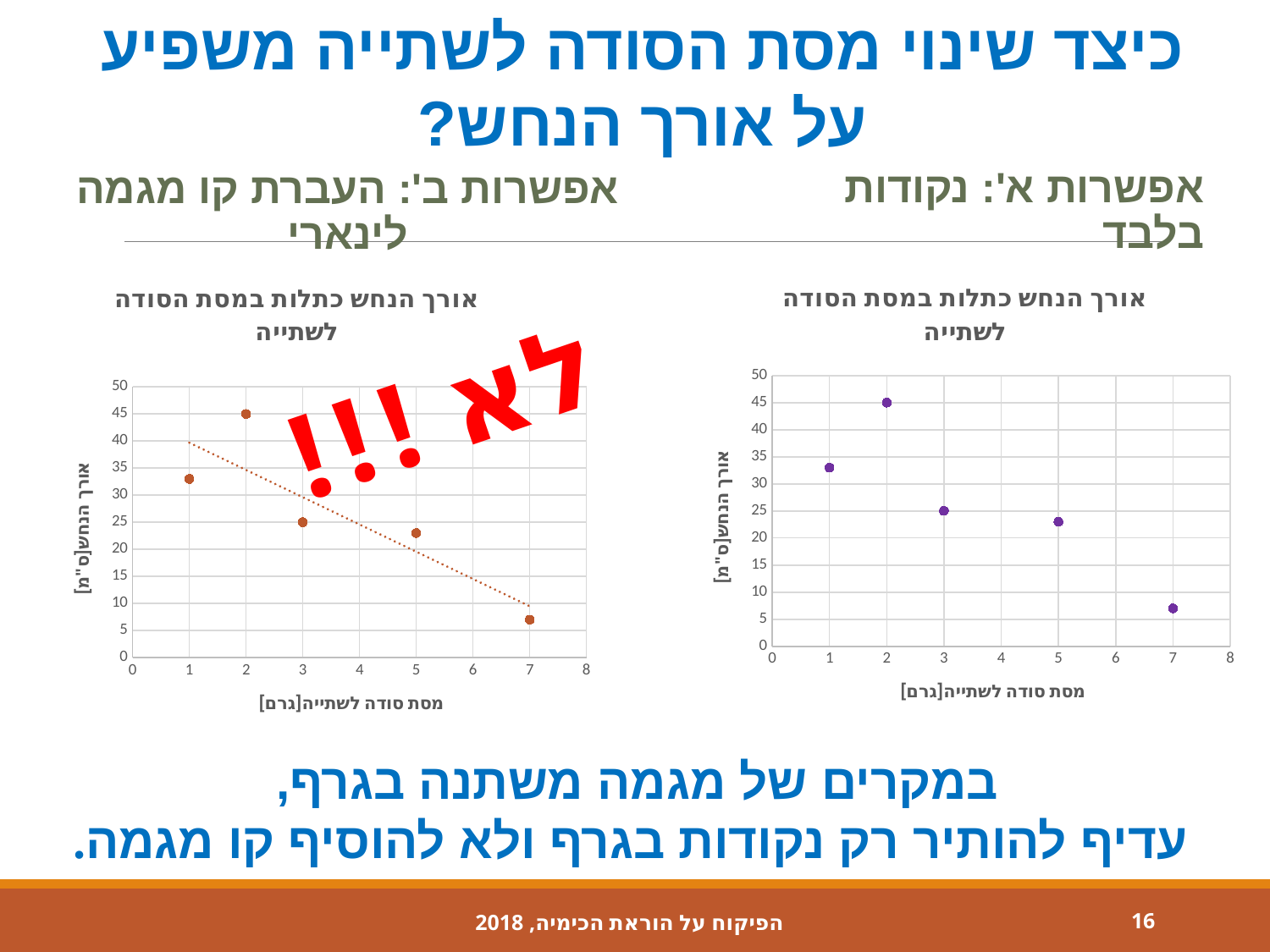
In the chart on the left side of the slide, what is the difference between the snake length at 2 grams and at 3 grams? 20 In the chart on the left side of the slide, which point has a larger snake length: the one at 1 gram or the one at 3 grams? 1 gram In the chart on the left side of the slide, do the snake length values generally rise or fall as the soda mass increases? fall In the chart on the right side of the slide, what is the snake length (y value) at a soda mass of 3 grams? 25 Which of the two charts on the slide includes a dotted trend line through the points? the chart on the left In the chart on the right side of the slide, at which soda mass (x value) is the snake length lowest? 7 What kind of chart is the chart on the right side of the slide? scatter chart In the chart on the right side of the slide, at which soda mass (x value) is the snake length highest? 2 In the chart on the right side of the slide, how many data points are plotted? 5 In the chart on the right side of the slide, what is the snake length (y value) at a soda mass of 2 grams? 45 In the chart on the right side of the slide, is the snake length at a soda mass of 7 grams greater or less than 10? less In the chart on the right side of the slide, is the snake length at a soda mass of 1 gram greater or less than 30? greater